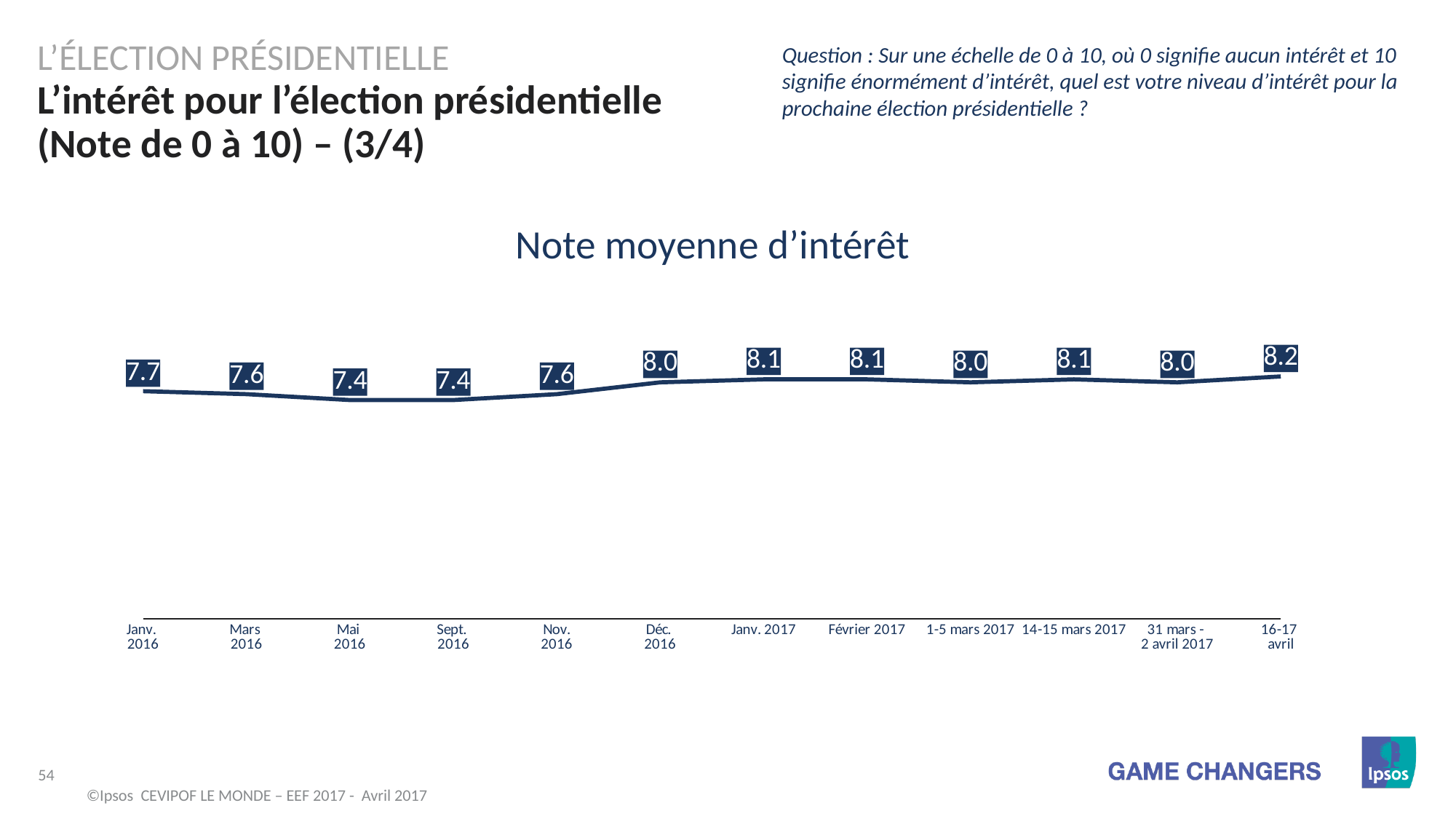
What is the average interest score for 16-17 avril? 8.2 What is the average interest score for Janv. 2016? 7.7 Overall, do the values rise or fall from Janv. 2016 to 16-17 avril? Rise What is the lowest average interest score shown on the chart? 7.4 How many data points are plotted on the chart? 12 What kind of chart is shown on the slide? Line chart Which is larger, the score for Nov. 2016 or the score for Janv. 2017? Janv. 2017 What is the difference between the scores for 16-17 avril and Mai 2016? 0.8 What is the average interest score for Déc. 2016? 8.0 What is the difference between the scores for Janv. 2016 and Sept. 2016? 0.3 What is the title of the chart? Note moyenne d'intérêt Which period has the highest average interest score? 16-17 avril